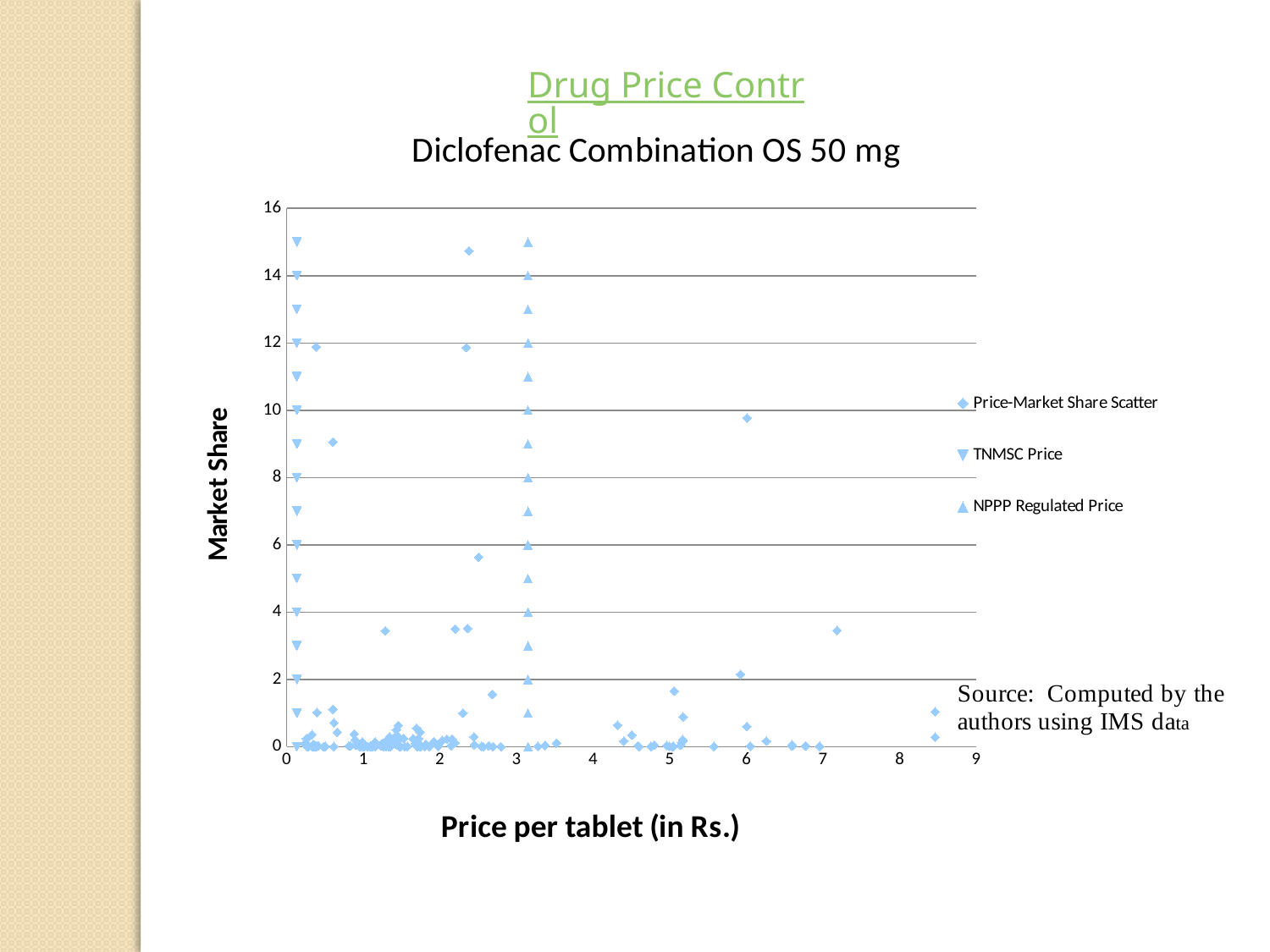
What is the label of the x axis? Price per tablet (in Rs.) Is the price at which the TNMSC Price markers are plotted greater or less than 1 Rs.? less How many series does the legend list? 3 What is the highest value shown on the x axis (Price per tablet)? 9 Which series is plotted at a higher price per tablet, TNMSC Price or NPPP Regulated Price? NPPP Regulated Price What kind of chart is shown on the slide? scatter chart Is the price at which the NPPP Regulated Price markers are plotted greater or less than 2 Rs.? greater Is the Price-Market Share Scatter point near a price of 7.2 greater or less than 4 in market share? less What is the highest value shown on the y axis (Market Share)? 16 What is the title of the chart? Diclofenac Combination OS 50 mg